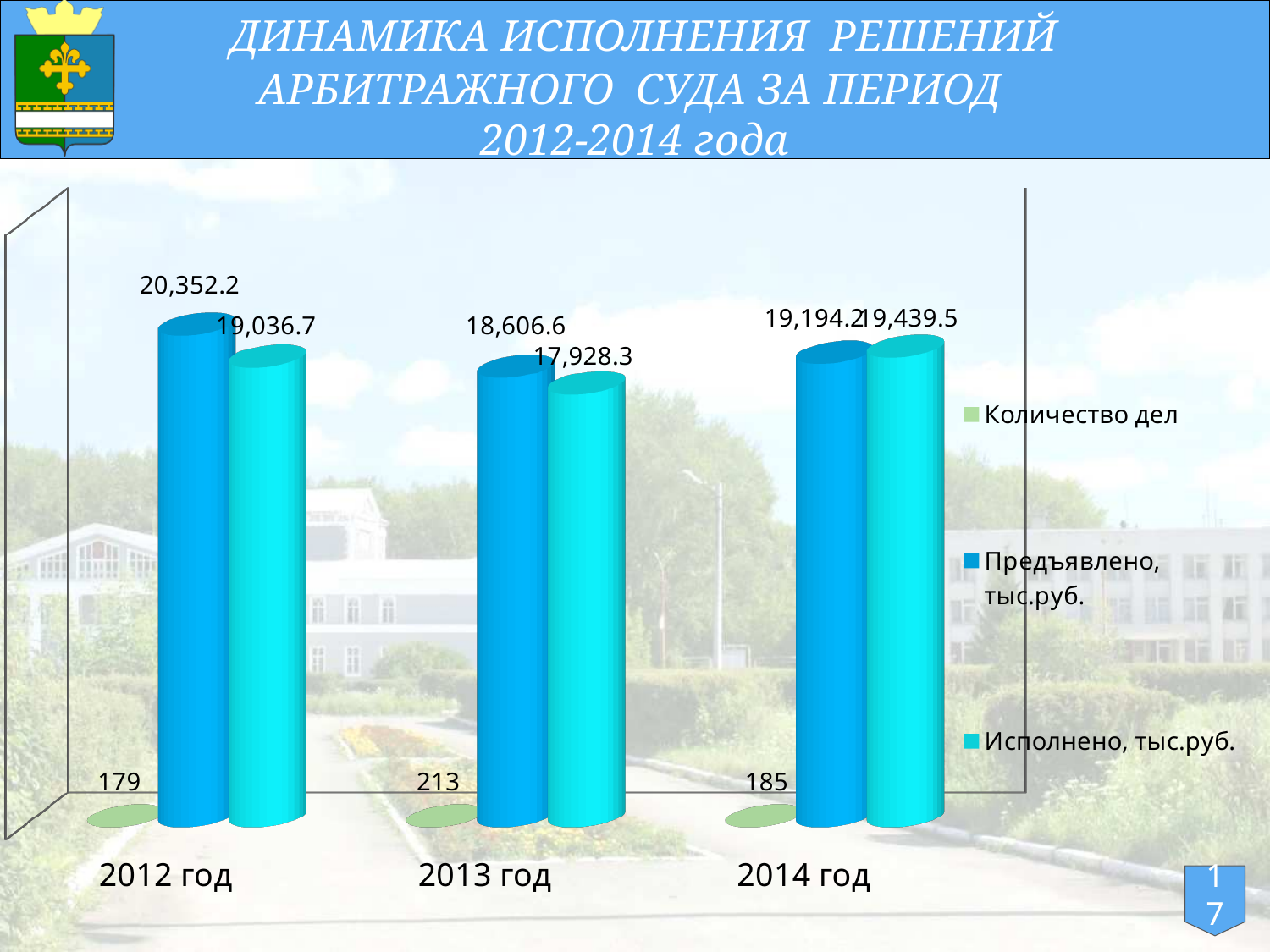
In which year is Количество дел the highest? 2013 год How many years (categories) are shown on the x axis? 3 What is the value of Предъявлено, тыс.руб. for 2012 год? 20,352.2 In which year is Исполнено, тыс.руб. the highest? 2014 год By how much does Количество дел in 2013 год exceed that in 2012 год? 34 How many series does the legend list? 3 In which year is Предъявлено, тыс.руб. the lowest? 2013 год In 2014 год, which is larger: Предъявлено, тыс.руб. or Исполнено, тыс.руб.? Исполнено, тыс.руб. What kind of chart is shown on the slide? Bar chart What is the difference between Предъявлено and Исполнено (тыс.руб.) in 2012 год? 1,315.5 What is the Количество дел for 2014 год? 185 What is the value of Исполнено, тыс.руб. for 2013 год? 17,928.3